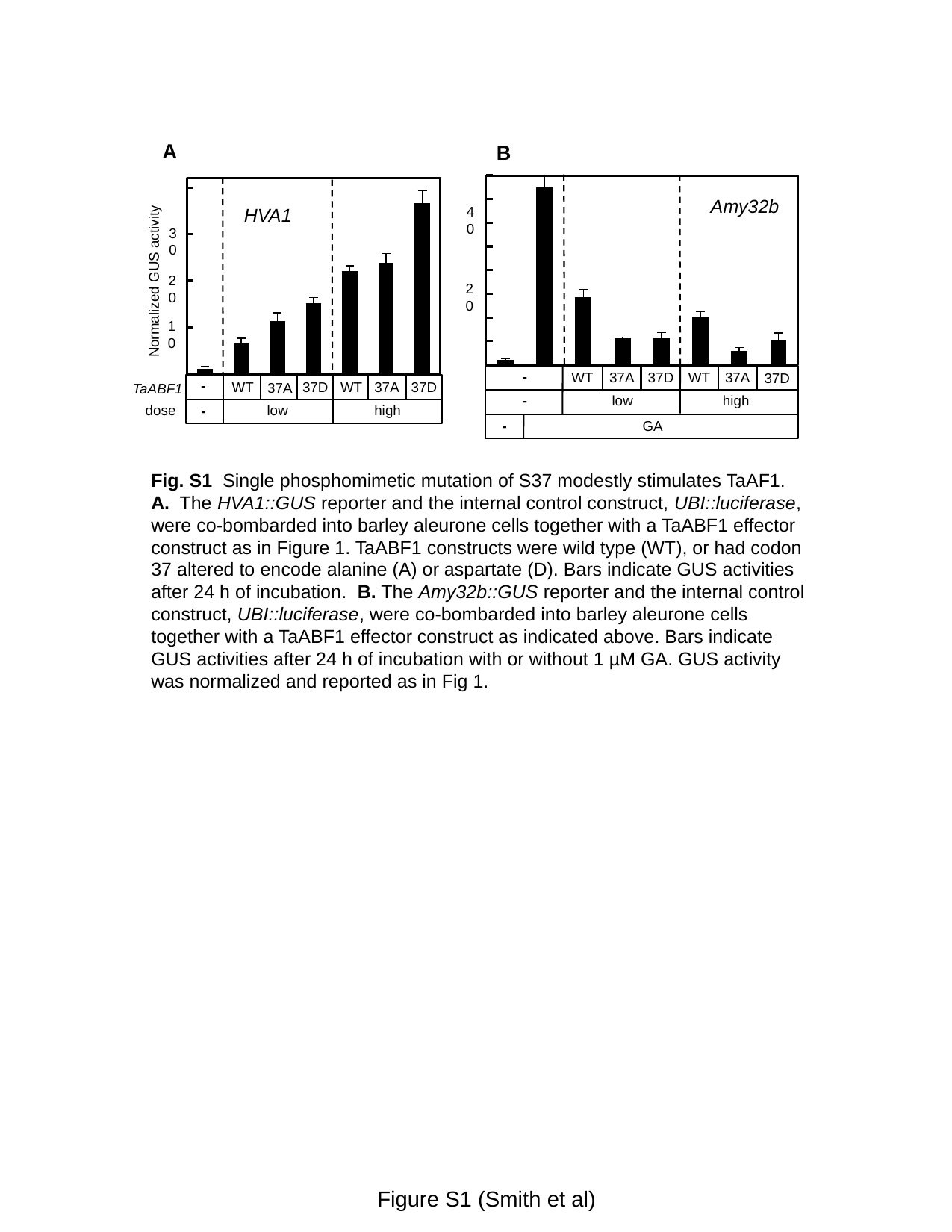
In chart B (Amy32b), is the value for WT at low dose greater or less than 20? less What kind of chart is chart A (HVA1)? bar chart In chart A (HVA1), which bar is the highest? 37D at high dose In chart A (HVA1), how many bars are plotted? 7 In chart B (Amy32b), which bar is the highest? - with GA (no TaABF1) What is the y-axis label of chart A? Normalized GUS activity In chart A (HVA1), which bar is the lowest? - (no TaABF1) In chart A (HVA1), do the bar values rise or fall from left to right? rise In chart B (Amy32b), which is larger, WT at low dose or WT at high dose? WT at low dose In chart A (HVA1), is the value for 37D at high dose greater or less than 30? greater In chart A (HVA1), is the value for WT at low dose greater or less than 10? less